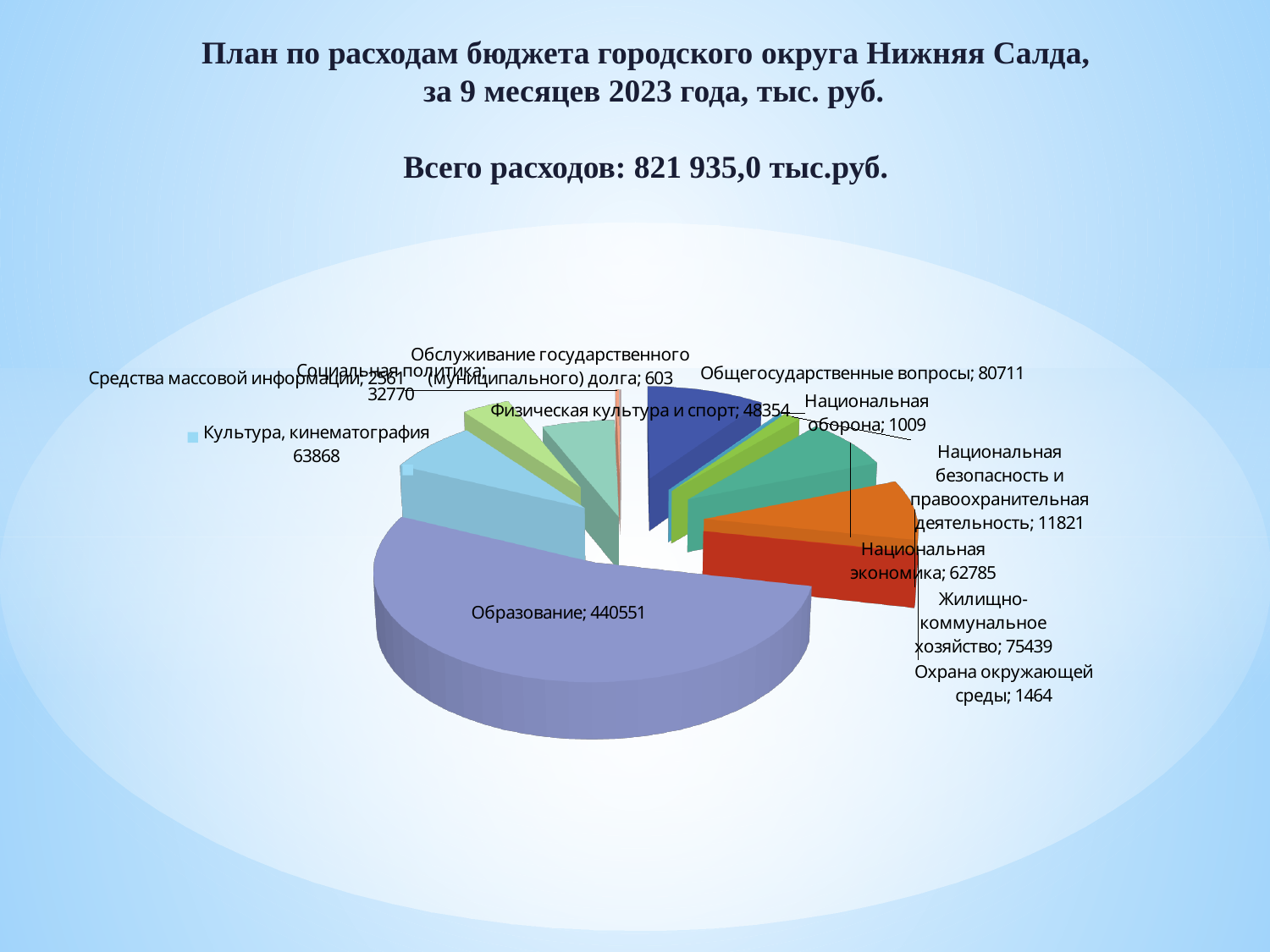
What is the difference between Общегосударственные вопросы and Жилищно-коммунальное хозяйство? 5272 What is the value for Общегосударственные вопросы? 80711 What kind of chart is shown on the slide? Pie chart What is the value for Образование? 440551 Which is larger: Культура, кинематография or Национальная экономика? Культура, кинематография Which category has the largest slice of the pie? Образование Which category has the smallest value? Обслуживание государственного (муниципального) долга What is the value for Физическая культура и спорт? 48354 What is the value for Жилищно-коммунальное хозяйство? 75439 How many categories are shown in the pie chart? 12 What is the value for Национальная оборона? 1009 What total expenditure is stated in the slide title? 821 935,0 тыс.руб.